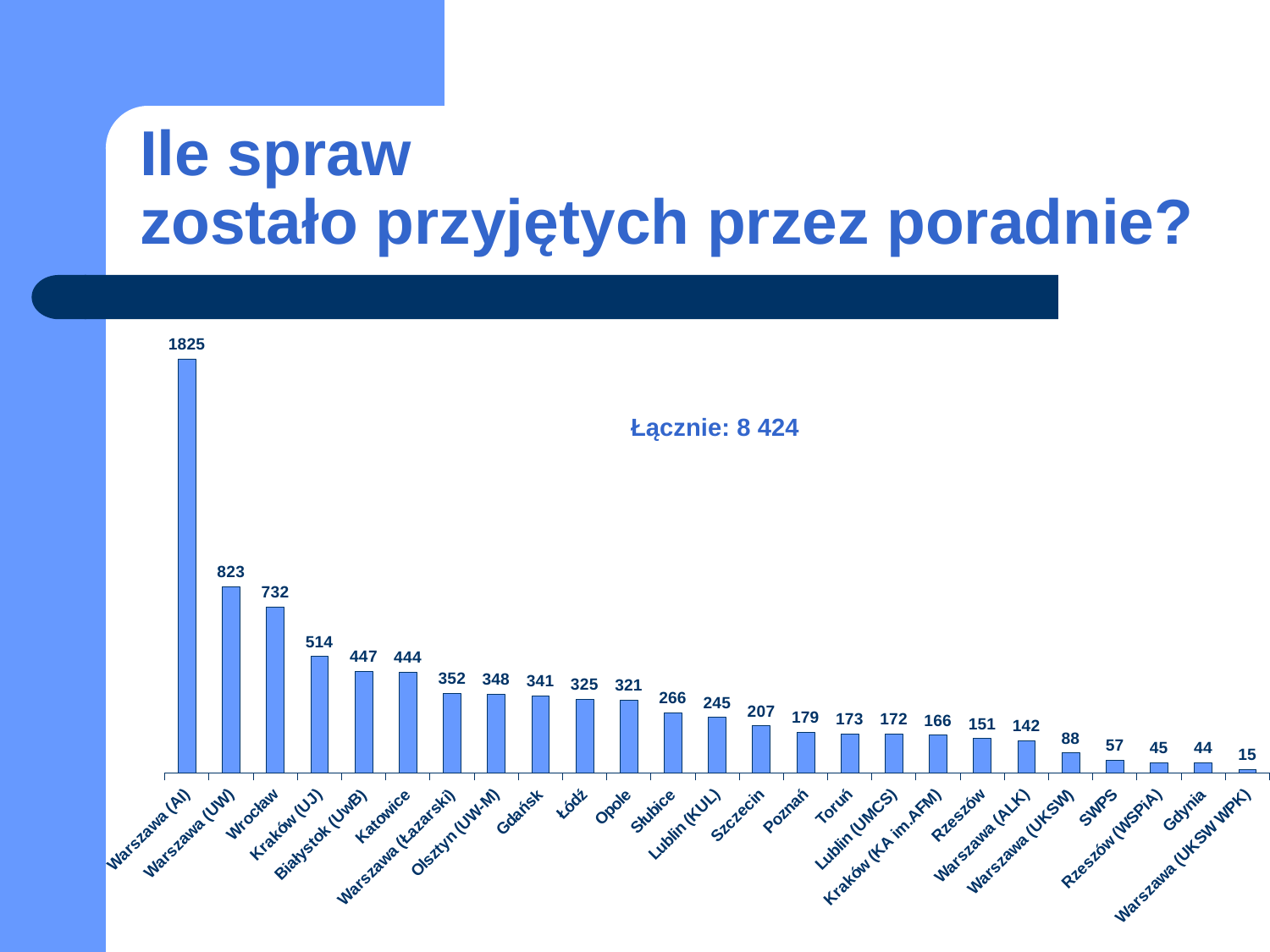
What is the difference between the values for Warszawa (AI) and Warszawa (UW)? 1002 How many cases does the chart show for Wrocław? 732 What value is shown for Gdańsk? 341 Which category has the lowest value on the chart? Warszawa (UKSW WPK) Which category has the highest value on the chart? Warszawa (AI) What is the difference between the values for Kraków (UJ) and Katowice? 70 What value is shown for Lublin (KUL)? 245 Which is larger, the value for SWPS or the value for Warszawa (UKSW)? Warszawa (UKSW) What total is stated in the text annotation on the chart? Łącznie: 8 424 Which is larger, the value for Szczecin or the value for Poznań? Szczecin What kind of chart is shown on the slide? bar chart How many categories are shown on the chart? 25